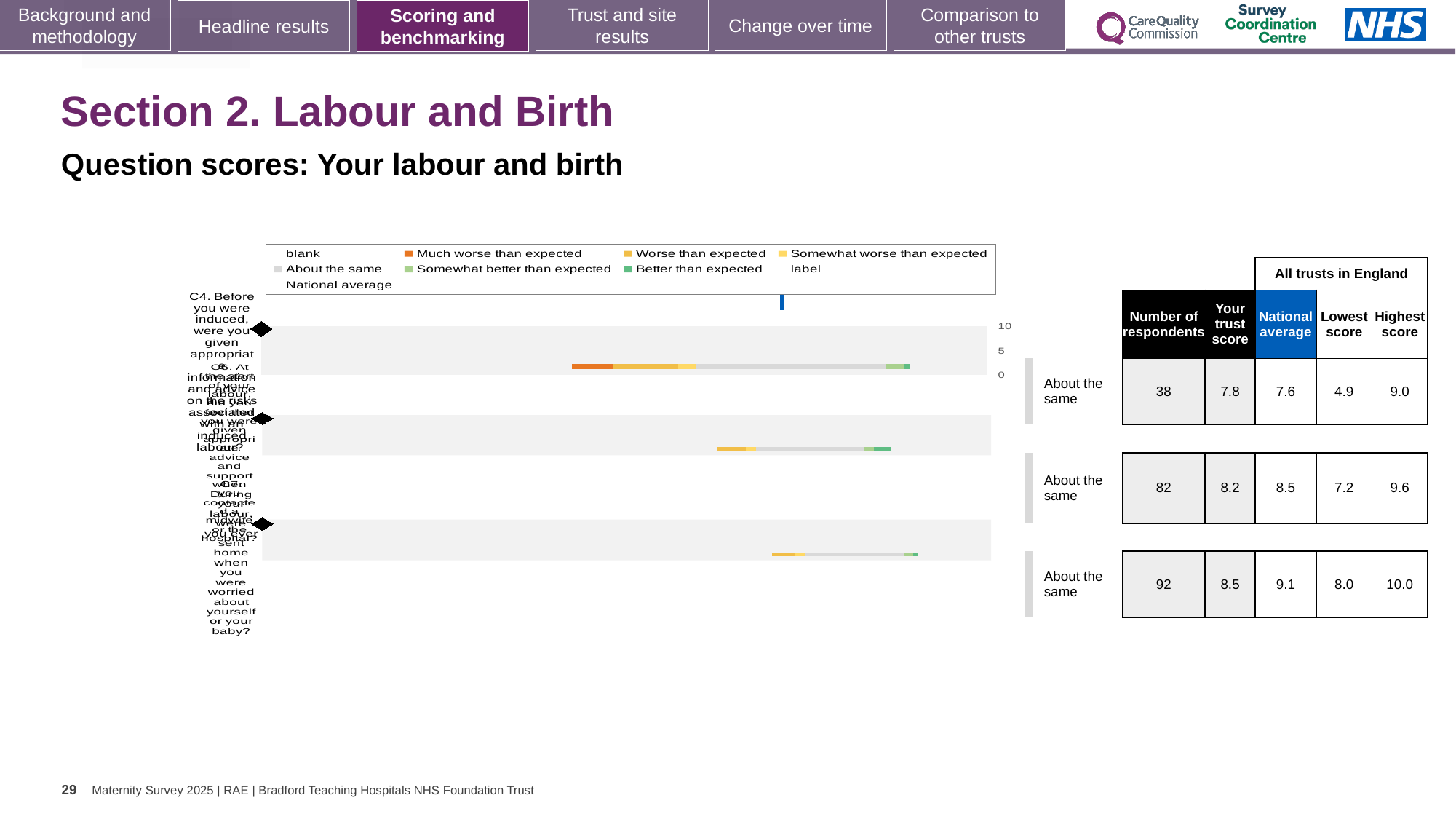
In the table next to the chart, what is the trust score for the top row? 7.8 In the table next to the chart, what is the national average for the second row? 8.5 What is the highest value shown on the chart's score axis? 10 What benchmark category is shown beside each of the three rows? About the same In the table next to the chart, what is the highest score for the third (bottom) row? 10.0 Which row in the table has the largest number of respondents? the third (bottom) row, 92 What is the difference between the national average and the trust score for the third (bottom) row? 0.6 Which legend entry is shown in dark orange? Much worse than expected In the table next to the chart, what is the lowest score for the top row? 4.9 How many question rows (bars) are plotted in the chart? 3 In the table next to the chart, what is the number of respondents for the top row? 38 What kind of chart is shown on the slide? bar chart